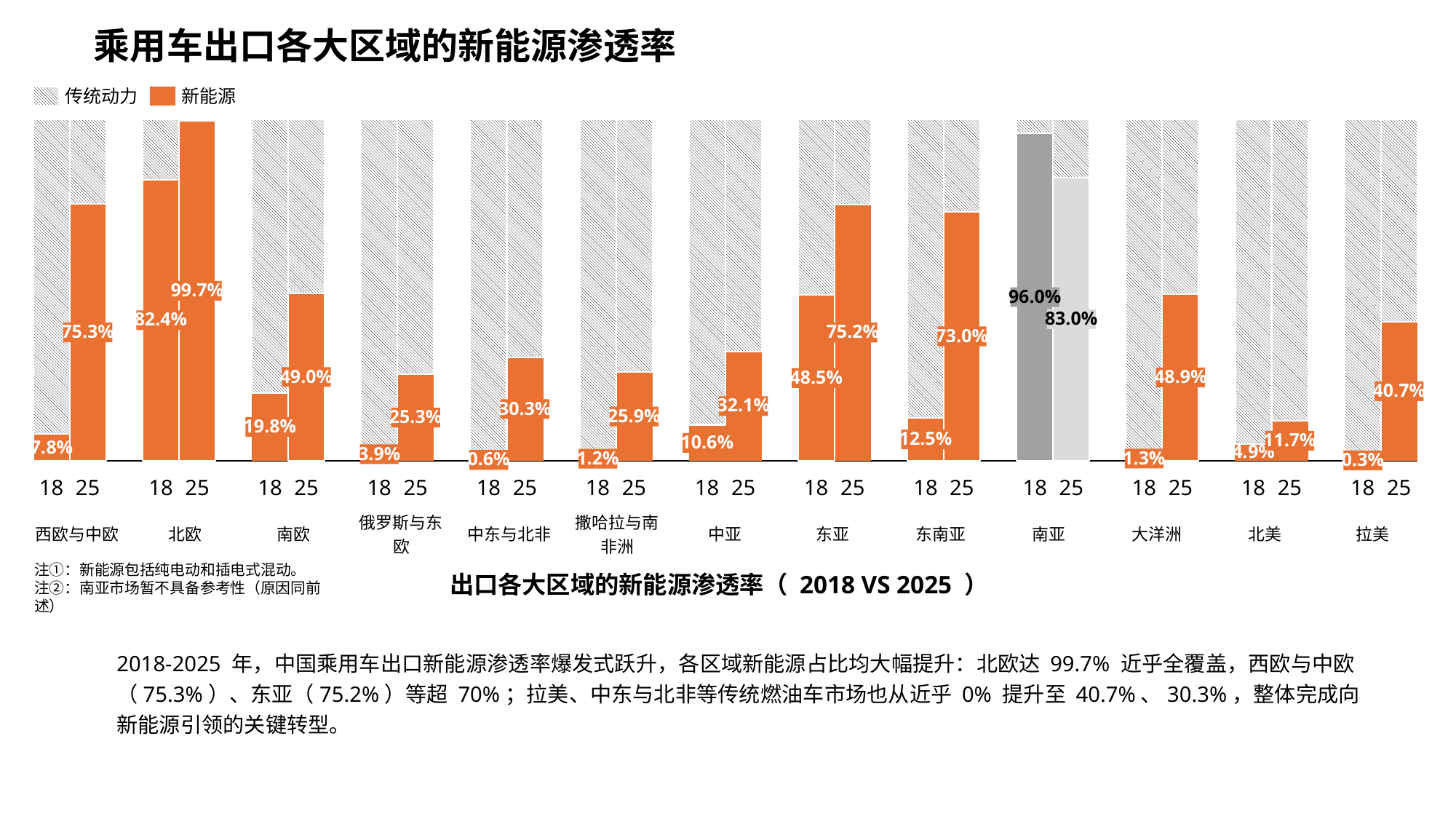
What kind of chart is shown on the slide? Bar chart What is the new energy penetration rate for 西欧与中欧 in 2018? 7.8% What is the new energy penetration rate for 北欧 in 2025? 99.7% What is the title of the chart? 出口各大区域的新能源渗透率（2018 VS 2025） What is the new energy penetration rate for 拉美 in 2025? 40.7% What is the new energy penetration rate for 南亚 in 2018? 96.0% Which region has the highest new energy penetration rate in 2025? 北欧 How many series does the legend list? 2 How many regions are shown on the x axis of the chart? 13 Which is larger, the 2025 new energy penetration rate for 东亚 or for 东南亚? 东亚 What is the difference between the 2025 and 2018 new energy penetration rates for 东南亚? 60.5% Which region has the lowest new energy penetration rate in 2018? 拉美